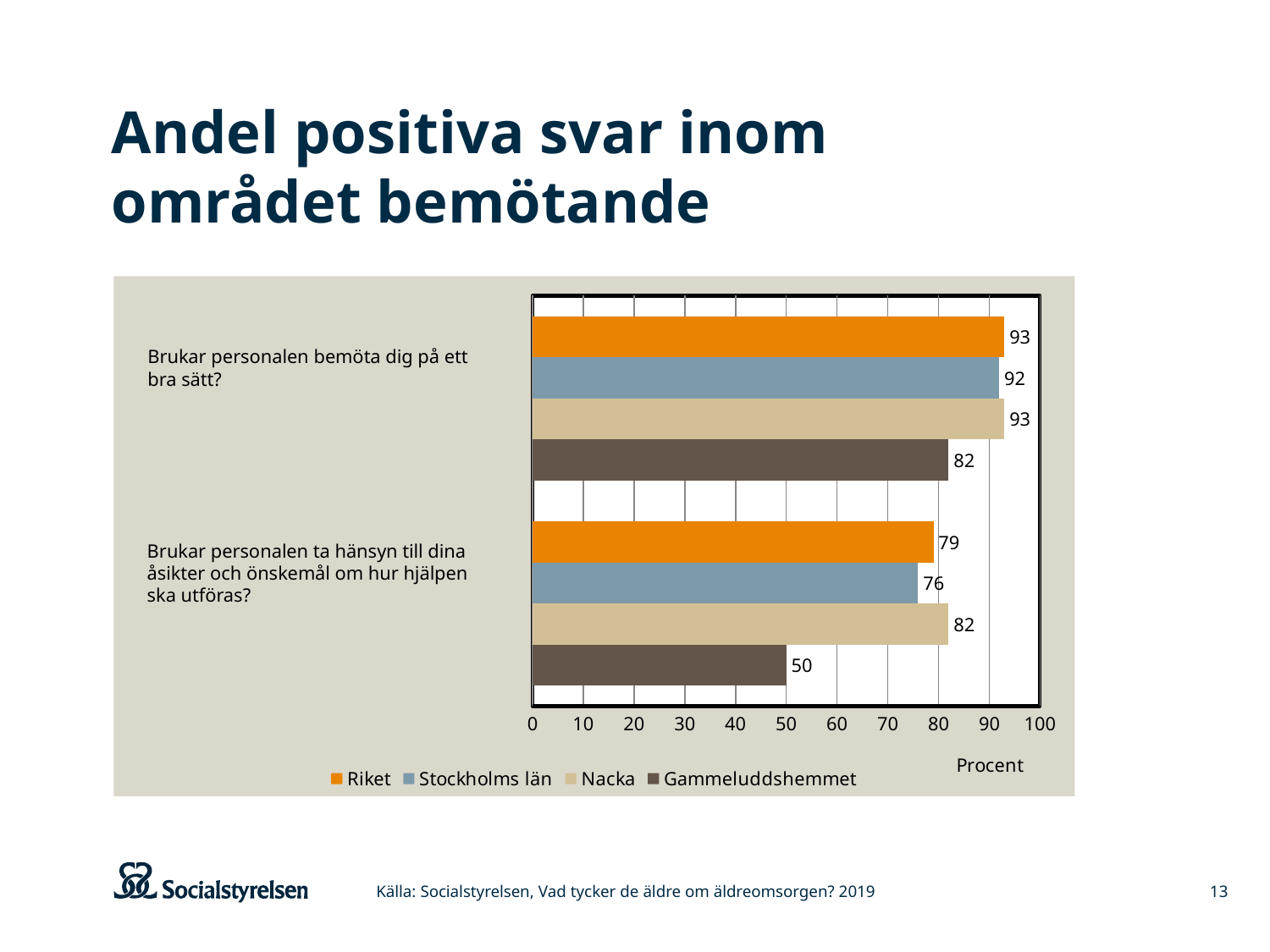
What is the value for Nacka for the question "Brukar personalen ta hänsyn till dina åsikter och önskemål om hur hjälpen ska utföras?"? 82 What is the difference between the Nacka and Gammeluddshemmet values for the question "Brukar personalen ta hänsyn till dina åsikter och önskemål om hur hjälpen ska utföras?"? 32 For the question "Brukar personalen bemöta dig på ett bra sätt?", which is larger: the value for Stockholms län or the value for Gammeluddshemmet? Stockholms län How many series does the legend list? 4 Which series has the lowest value for the question "Brukar personalen ta hänsyn till dina åsikter och önskemål om hur hjälpen ska utföras?"? Gammeluddshemmet What is the value for Riket for the question "Brukar personalen bemöta dig på ett bra sätt?"? 93 Which series has the highest value for the question "Brukar personalen ta hänsyn till dina åsikter och önskemål om hur hjälpen ska utföras?"? Nacka What is the value for Gammeluddshemmet for the question "Brukar personalen ta hänsyn till dina åsikter och önskemål om hur hjälpen ska utföras?"? 50 What kind of chart is shown on the slide? bar chart What is the value for Stockholms län for the question "Brukar personalen ta hänsyn till dina åsikter och önskemål om hur hjälpen ska utföras?"? 76 What is the label on the horizontal axis of the chart? Procent How many survey questions (categories) are shown on the chart? 2